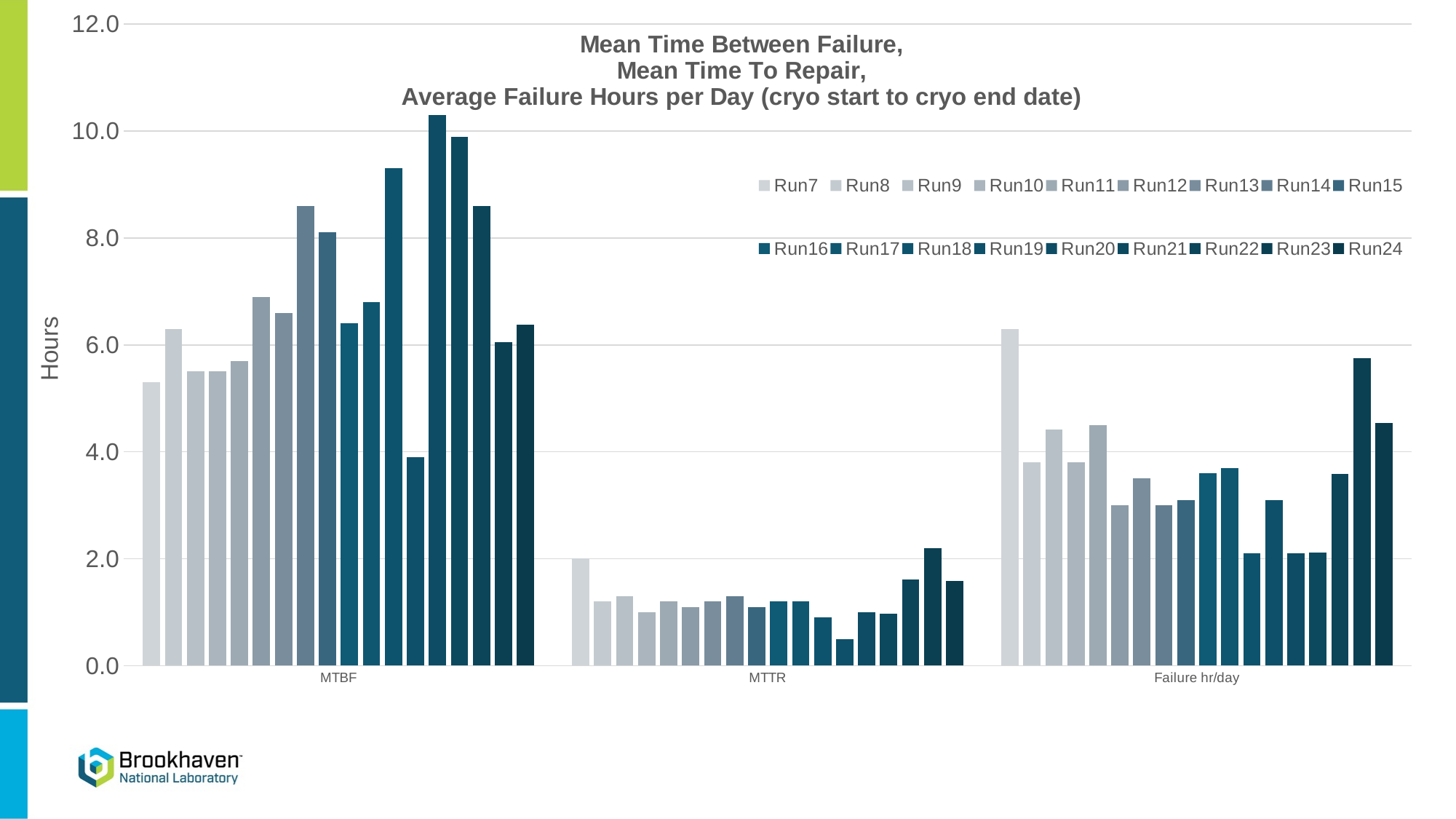
Is the Run24 value for MTTR greater or less than 2.0? less Is the Run24 value for Failure hr/day greater or less than 4.0? greater Which category contains the tallest bar in the chart? MTBF Is the Run7 value for Failure hr/day greater or less than 6.0? greater What kind of chart is shown on the slide? bar chart Which category has the lowest bars overall? MTTR What is the highest value shown on the y axis? 12.0 What is the label of the y axis? Hours How many series does the legend list? 18 How many categories are shown on the x axis? 3